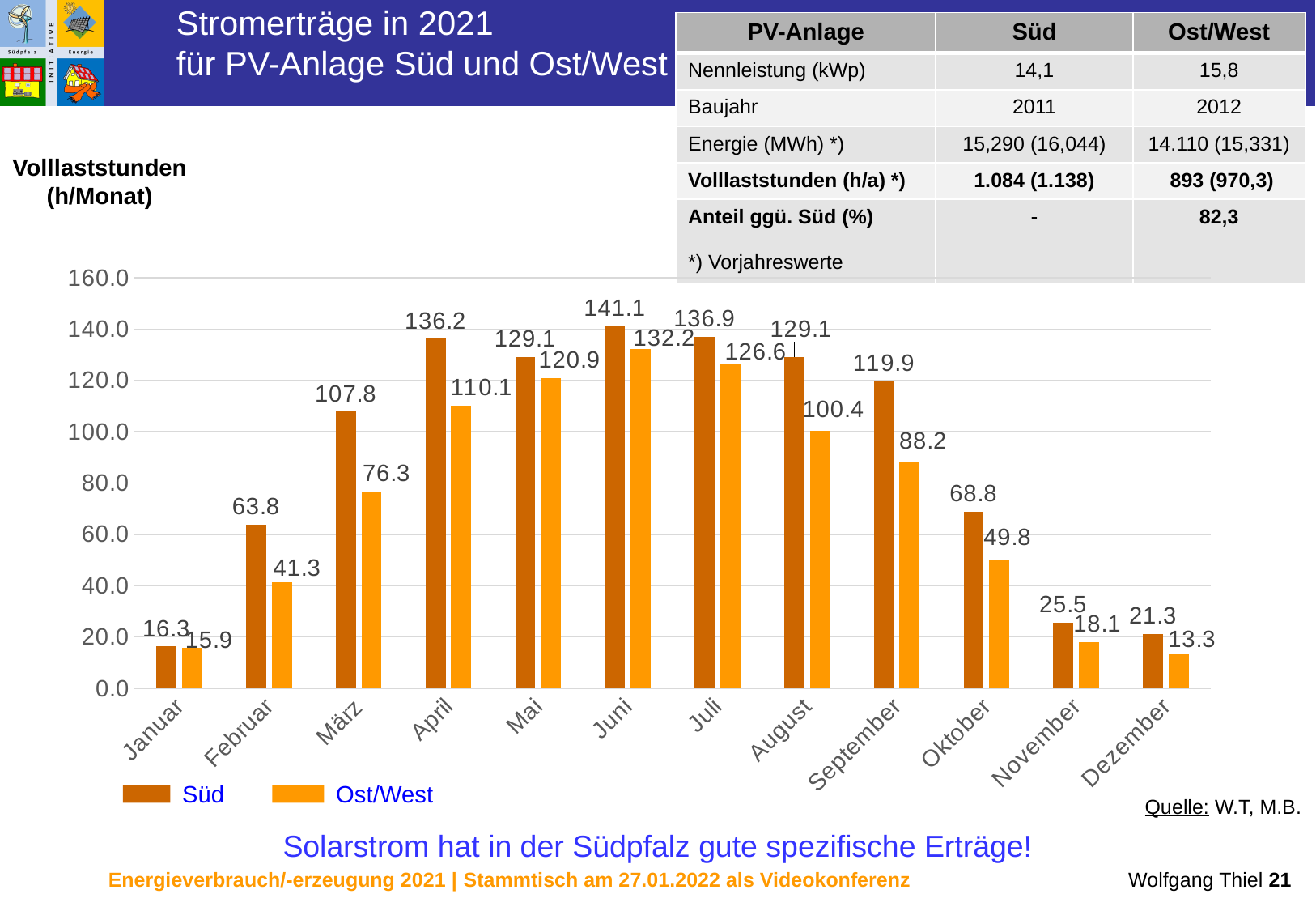
What kind of chart is shown on the slide? bar chart Which month has the lowest Ost/West value? Dezember What is the Ost/West value for März? 76.3 What is the Süd value for Juni? 141.1 Which is larger in Mai, the Süd value or the Ost/West value? Süd How many series does the legend list? 2 Which month has the highest Süd value? Juni Do the Süd values rise or fall from Juli to Dezember? fall What is the Ost/West value for Dezember? 13.3 What is the difference between the Süd and Ost/West values for August? 28.7 What is the Süd value for Oktober? 68.8 How many months are shown on the x axis? 12